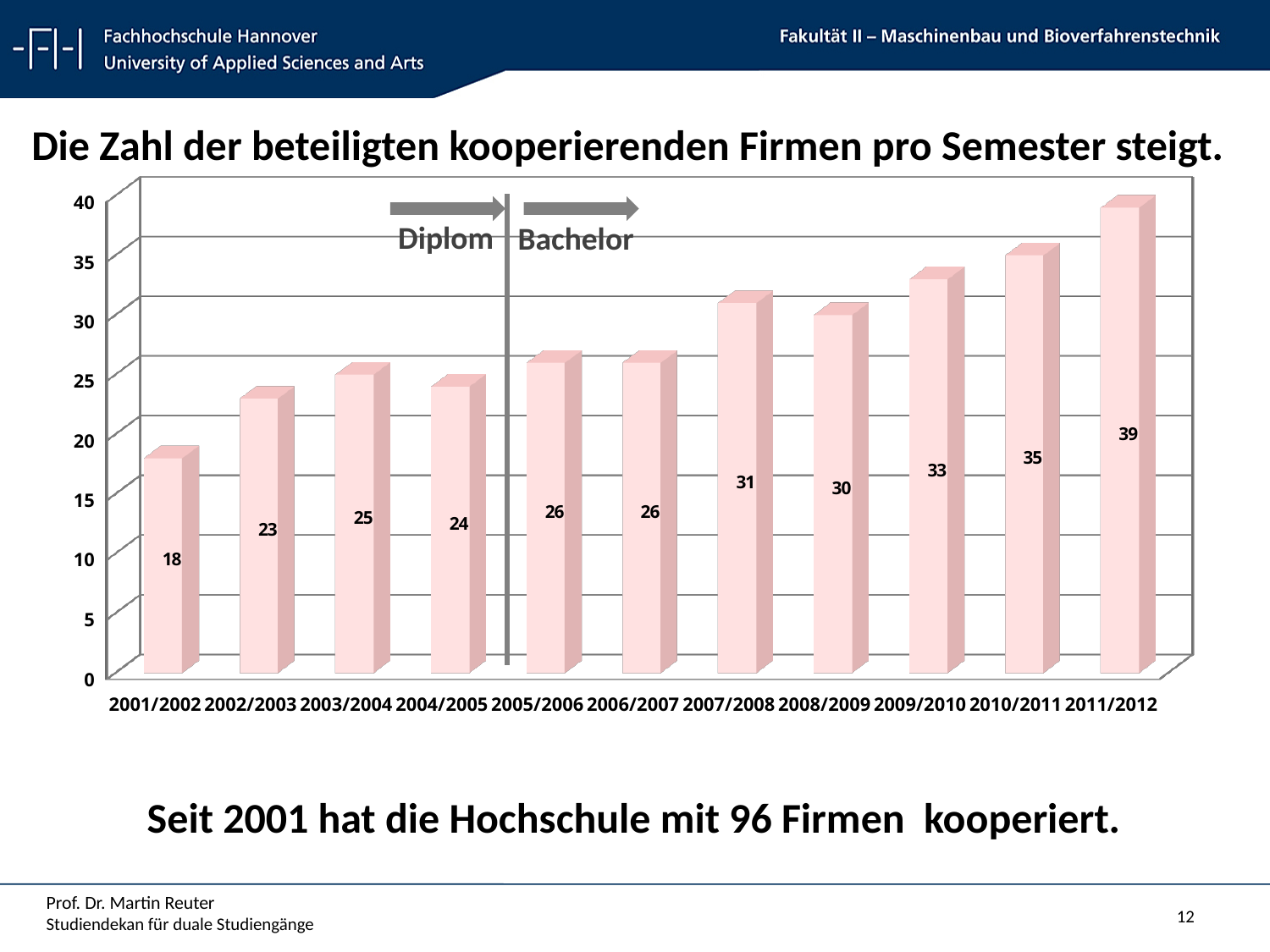
Which category has the highest value? 2011/2012 How many categories are shown on the x axis? 11 What kind of chart is shown on the slide? bar chart Which category has the lowest value? 2001/2002 Which is larger, the value for 2003/2004 or the value for 2004/2005? 2003/2004 What is the difference between the values for 2009/2010 and 2008/2009? 3 Do the values generally rise or fall from 2001/2002 to 2011/2012? rise Is the value for 2008/2009 greater or less than 25? greater What is the difference between the values for 2011/2012 and 2001/2002? 21 What is the value for 2007/2008? 31 What is the value for 2010/2011? 35 What is the value for 2001/2002? 18